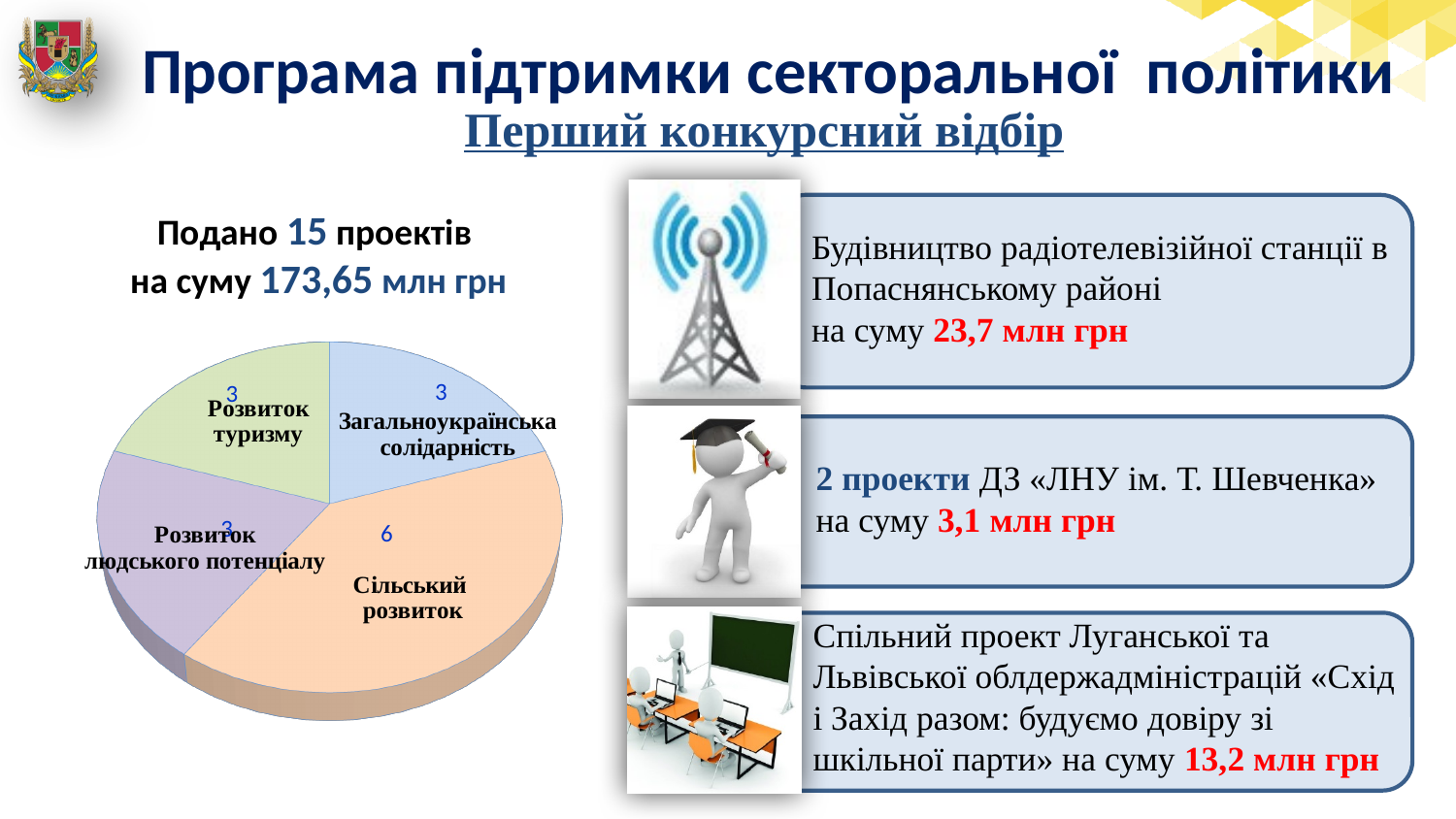
What share of the pie does Розвиток туризму represent? 20% What is the value for Загальноукраїнська солідарність in the pie chart? 3 What is the value for Сільський розвиток in the pie chart? 6 What is the value for Розвиток людського потенціалу in the pie chart? 3 What is the total of all slices in the pie chart? 15 How many slices does the pie chart have? 4 Which category has the largest slice in the pie chart? Сільський розвиток Which is larger: the value for Сільський розвиток or the value for Загальноукраїнська солідарність? Сільський розвиток What share of the pie does Сільський розвиток represent? 40% What kind of chart is shown on the slide? pie chart What is the value for Розвиток туризму in the pie chart? 3 What is the difference between the values for Сільський розвиток and Розвиток туризму? 3